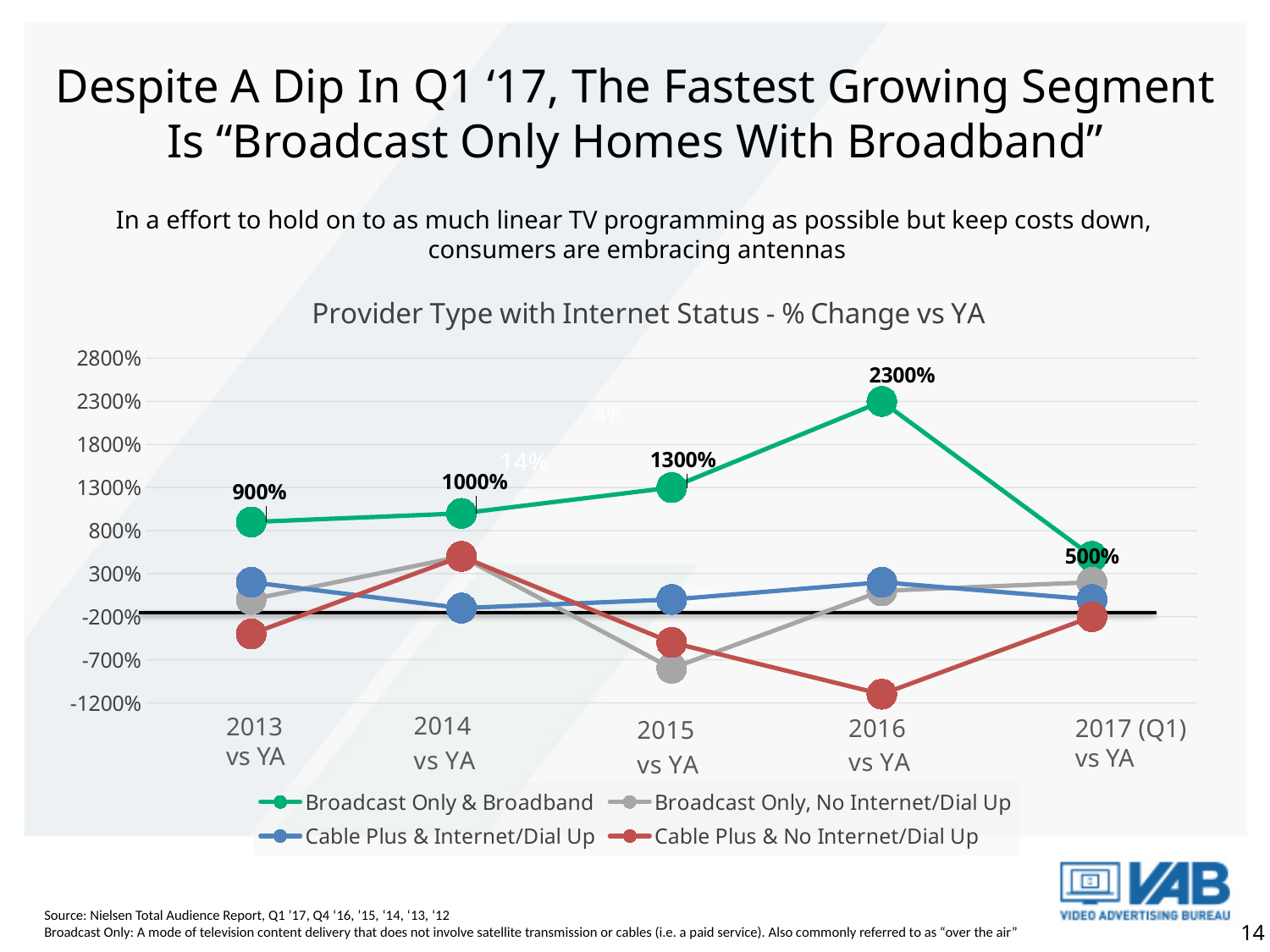
Which series is shown in green? Broadcast Only & Broadband What is the value for Broadcast Only & Broadband in 2016 vs YA? 2300% Is the value for Cable Plus & No Internet/Dial Up in 2016 vs YA greater or less than -700%? less What is the title of the chart? Provider Type with Internet Status - % Change vs YA What is the value for Broadcast Only & Broadband in 2013 vs YA? 900% What is the difference between the Broadcast Only & Broadband values for 2016 vs YA and 2015 vs YA? 1000% In which period is the Broadcast Only & Broadband value lowest? 2017 (Q1) vs YA What type of chart is shown on the slide? line chart How many series does the legend list? 4 What is the value for Broadcast Only & Broadband in 2017 (Q1) vs YA? 500% In which period does Broadcast Only & Broadband reach its highest value? 2016 vs YA How many time periods are shown on the x axis? 5